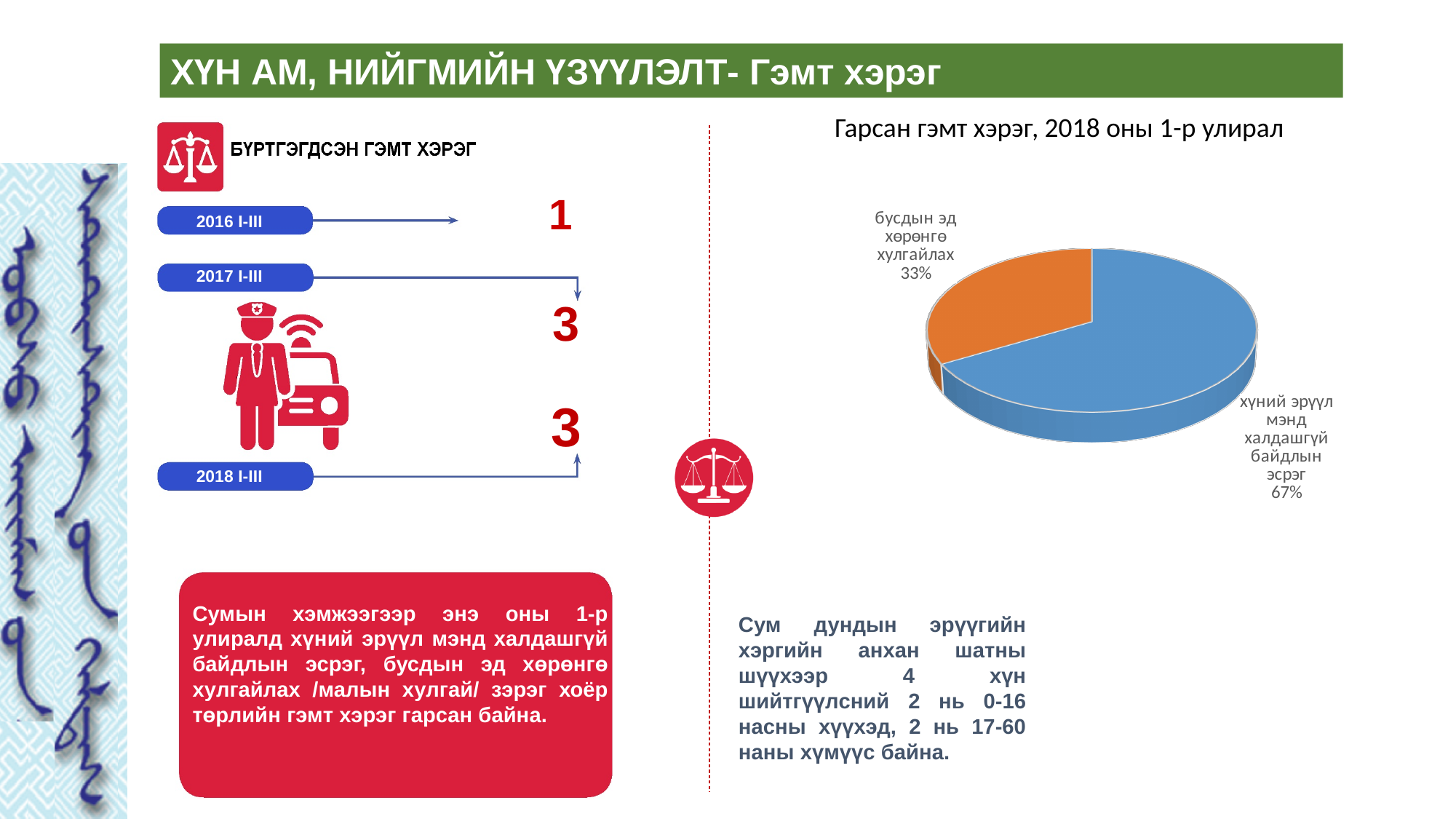
In the pie chart, what is the difference in percentage points between the two slices? 34 In the pie chart, which is larger: the share for "бусдын эд хөрөнгө хулгайлах" or the share for "хүний эрүүл мэнд халдашгүй байдлын эсрэг"? хүний эрүүл мэнд халдашгүй байдлын эсрэг What is the title of the pie chart? Гарсан гэмт хэрэг, 2018 оны 1-р улирал What colour is the "бусдын эд хөрөнгө хулгайлах" slice in the pie chart? Orange In the pie chart, what share is labelled for "хүний эрүүл мэнд халдашгүй байдлын эсрэг"? 67% What kind of chart is shown under the title "Гарсан гэмт хэрэг, 2018 оны 1-р улирал"? Pie chart Which slice of the pie chart is the smallest? бусдын эд хөрөнгө хулгайлах In the pie chart, what share is labelled for "бусдын эд хөрөнгө хулгайлах"? 33% How many slices does the pie chart have? 2 Which slice of the pie chart is the largest? хүний эрүүл мэнд халдашгүй байдлын эсрэг